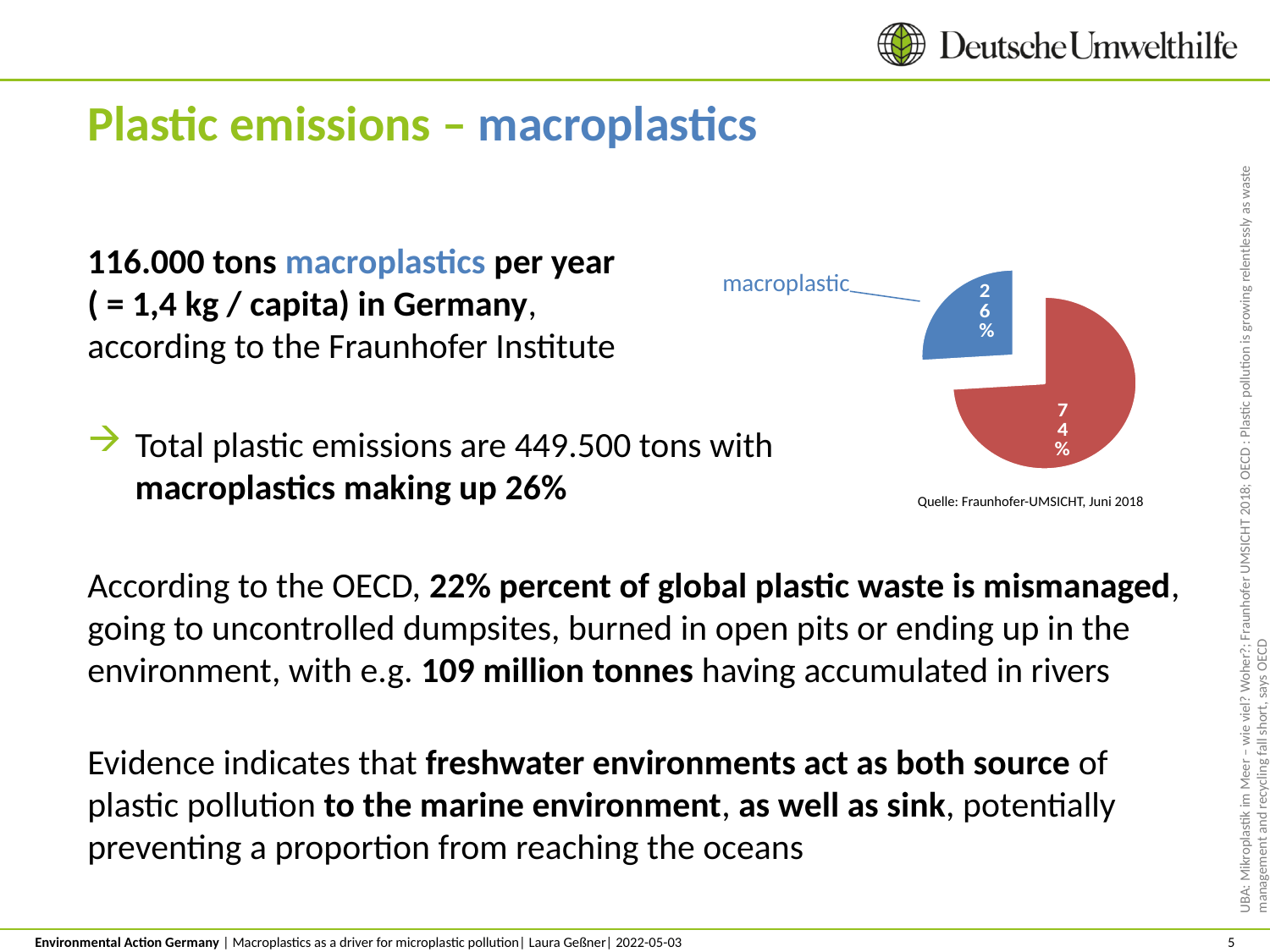
What colour is the macroplastic slice in the pie chart? blue What percentage is shown on the blue slice of the pie chart? 26% What source is cited below the pie chart? Quelle: Fraunhofer-UMSICHT, Juni 2018 What share of the pie chart does the macroplastic slice represent? 26% Which slice of the pie chart is the smallest? macroplastic How many slices does the pie chart have? 2 By how many percentage points does the red slice exceed the macroplastic slice in the pie chart? 48 What percentage is shown on the red slice of the pie chart? 74% Which slice of the pie chart is the largest, the macroplastic slice or the red slice? the red slice Is the macroplastic slice larger or smaller than the red slice in the pie chart? smaller What kind of chart is shown on the slide? pie chart Is the macroplastic share in the pie chart greater or less than 50%? less